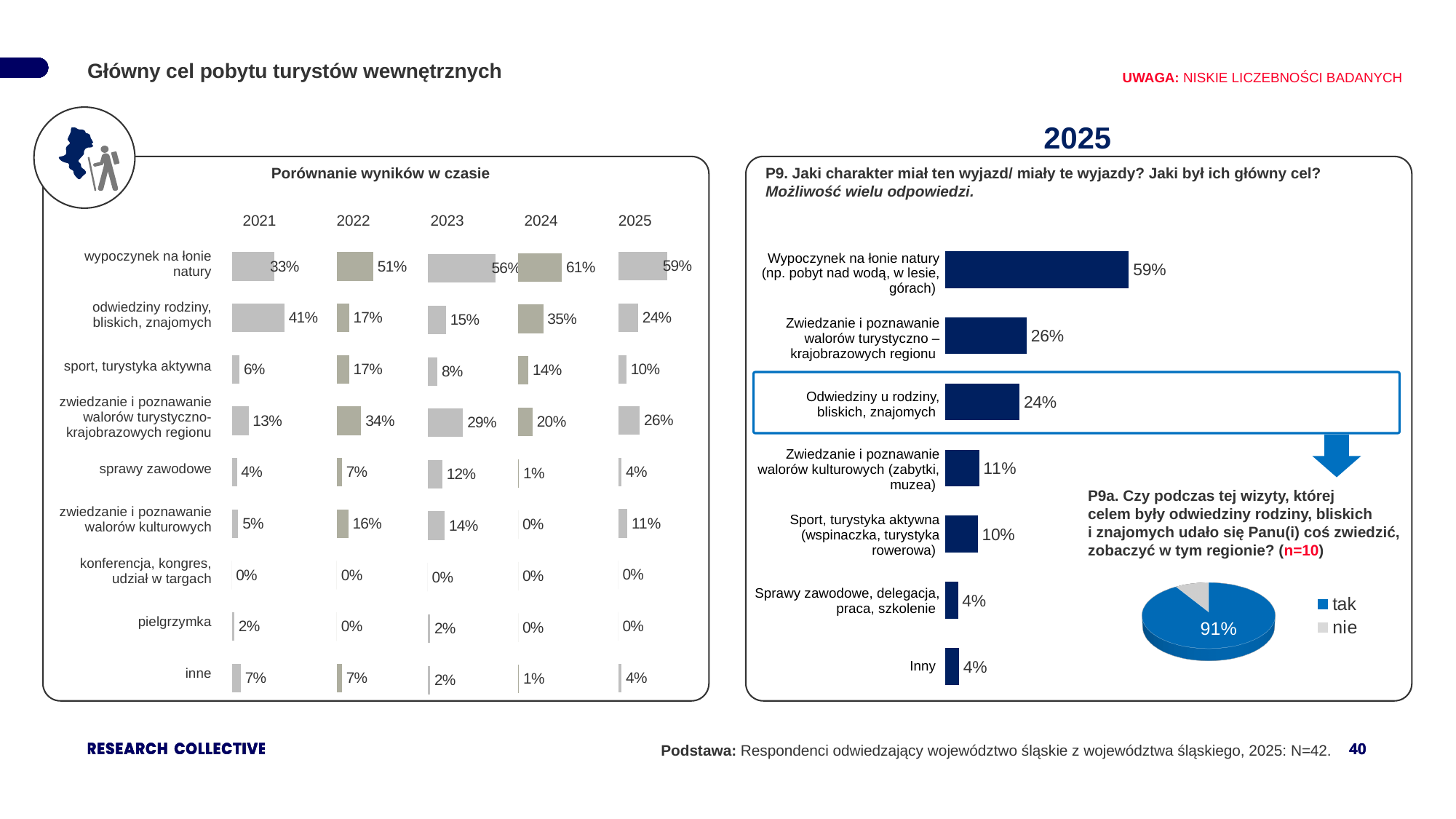
In the pie chart (P9a), what share of respondents answered 'tak'? 91% In the 2025 bar chart (P9), which is larger: 'Sport, turystyka aktywna' or 'Zwiedzanie i poznawanie walorów kulturowych'? Zwiedzanie i poznawanie walorów kulturowych In the 2025 bar chart (P9), how many categories are shown? 7 In the 'Porównanie wyników w czasie' chart, what is the value for 'sprawy zawodowe' in 2023? 12% In the 2025 bar chart (P9), what is the difference between 'Zwiedzanie i poznawanie walorów turystyczno – krajobrazowych regionu' and 'Odwiedziny u rodziny, bliskich, znajomych'? 2 percentage points In the 'Porównanie wyników w czasie' chart, how many years are compared? 5 What type of chart is used for P9a? Pie chart In the 'Porównanie wyników w czasie' chart, what is the difference between 'zwiedzanie i poznawanie walorów turystyczno-krajobrazowych regionu' in 2022 and in 2021? 21 percentage points In the 2025 bar chart (P9), what is the value for 'Wypoczynek na łonie natury'? 59% In the 'Porównanie wyników w czasie' chart, what is the value for 'odwiedziny rodziny, bliskich, znajomych' in 2021? 41% In the 'Porównanie wyników w czasie' chart, in which year was 'wypoczynek na łonie natury' highest? 2024 In the 2025 bar chart (P9), which category has the highest value? Wypoczynek na łonie natury